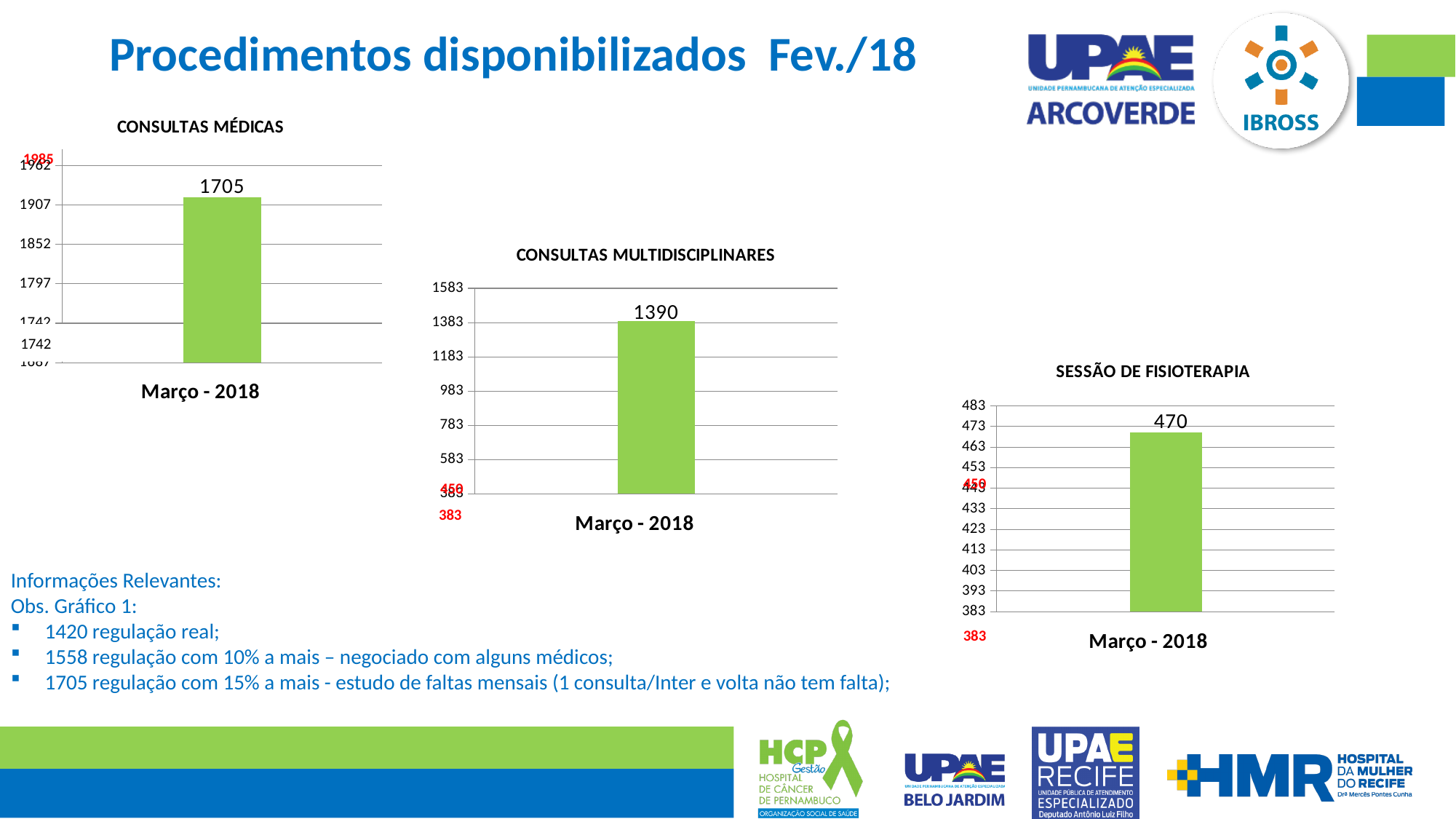
What colour are the bars in the three charts? green What kind of chart is the CONSULTAS MÉDICAS chart? bar chart What kind of chart is the SESSÃO DE FISIOTERAPIA chart? bar chart How many bars are plotted in the CONSULTAS MULTIDISCIPLINARES chart? 1 What is the difference between the CONSULTAS MÉDICAS value (1705) and the CONSULTAS MULTIDISCIPLINARES value (1390) for Março - 2018? 315 In the SESSÃO DE FISIOTERAPIA chart, what is the value for Março - 2018? 470 What is the category label on the x axis of the CONSULTAS MÉDICAS chart? Março - 2018 In the CONSULTAS MÉDICAS chart, what is the value for Março - 2018? 1705 Which chart shows the larger value for Março - 2018: CONSULTAS MÉDICAS or CONSULTAS MULTIDISCIPLINARES? CONSULTAS MÉDICAS How many categories are shown on the x axis of the SESSÃO DE FISIOTERAPIA chart? 1 In the CONSULTAS MULTIDISCIPLINARES chart, what is the value for Março - 2018? 1390 In the CONSULTAS MULTIDISCIPLINARES chart, is the value for Março - 2018 greater or less than 983? greater